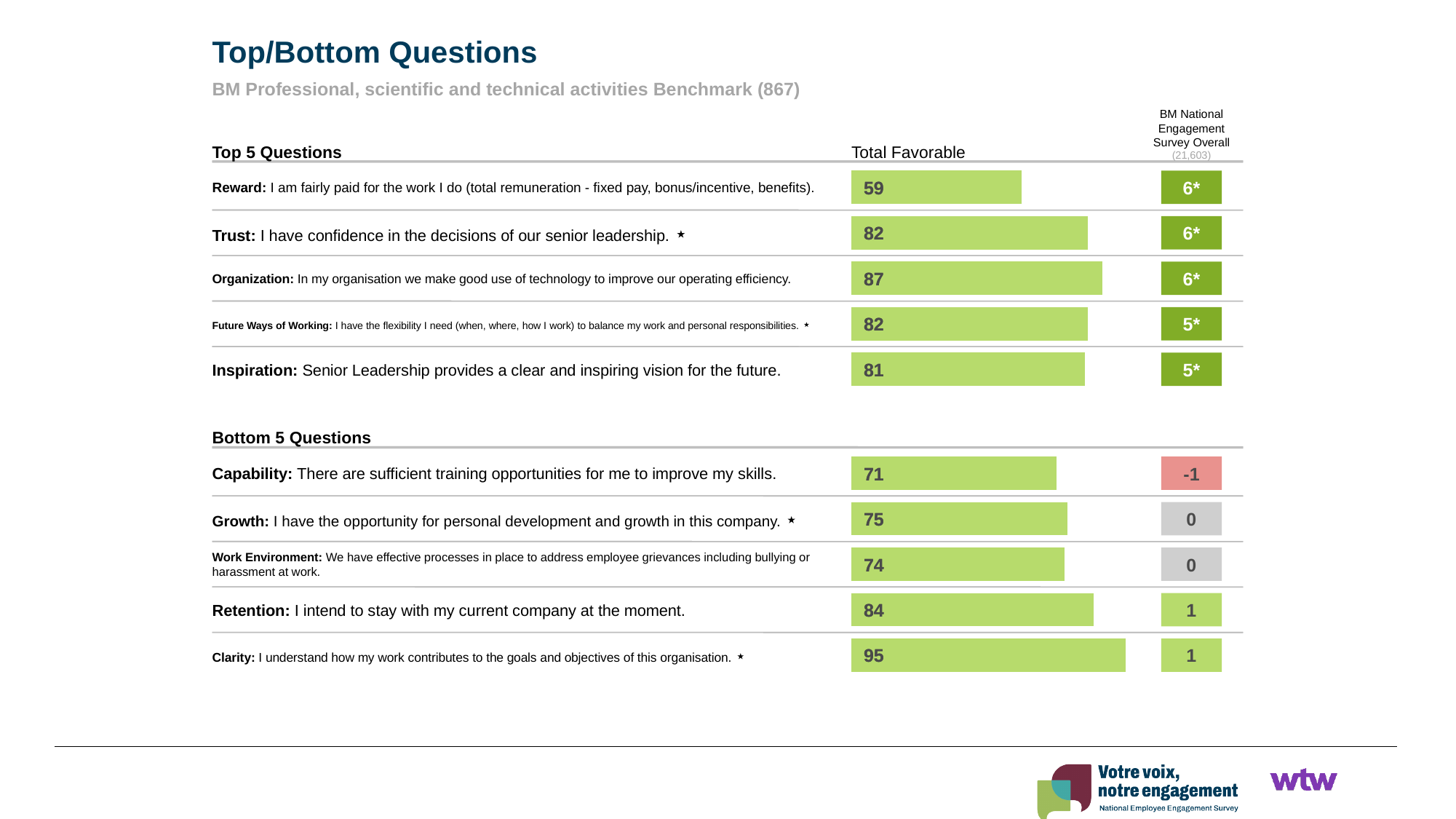
In the Bottom 5 Questions chart, which has a higher Total Favorable value, Growth or Work Environment? Growth In the Top 5 Questions chart, which question has the highest Total Favorable value? Organization In the Top 5 Questions chart, what is the Total Favorable value for Organization? 87 In the Bottom 5 Questions chart, which question has the lowest Total Favorable value? Capability In the Top 5 Questions chart, what is the difference between the Total Favorable values for Organization and Reward? 28 What kind of chart is used to show the Total Favorable values on the slide? Bar chart In the Top 5 Questions chart, which question has the lowest Total Favorable value? Reward In the Bottom 5 Questions chart, what is the Total Favorable value for Clarity? 95 How many questions are listed in the Bottom 5 Questions chart? 5 In the Bottom 5 Questions chart, what is the BM National Engagement Survey Overall difference shown for Capability? -1 In the Top 5 Questions chart, what is the Total Favorable value for Reward? 59 In the Bottom 5 Questions chart, what is the difference between the Total Favorable values for Clarity and Capability? 24